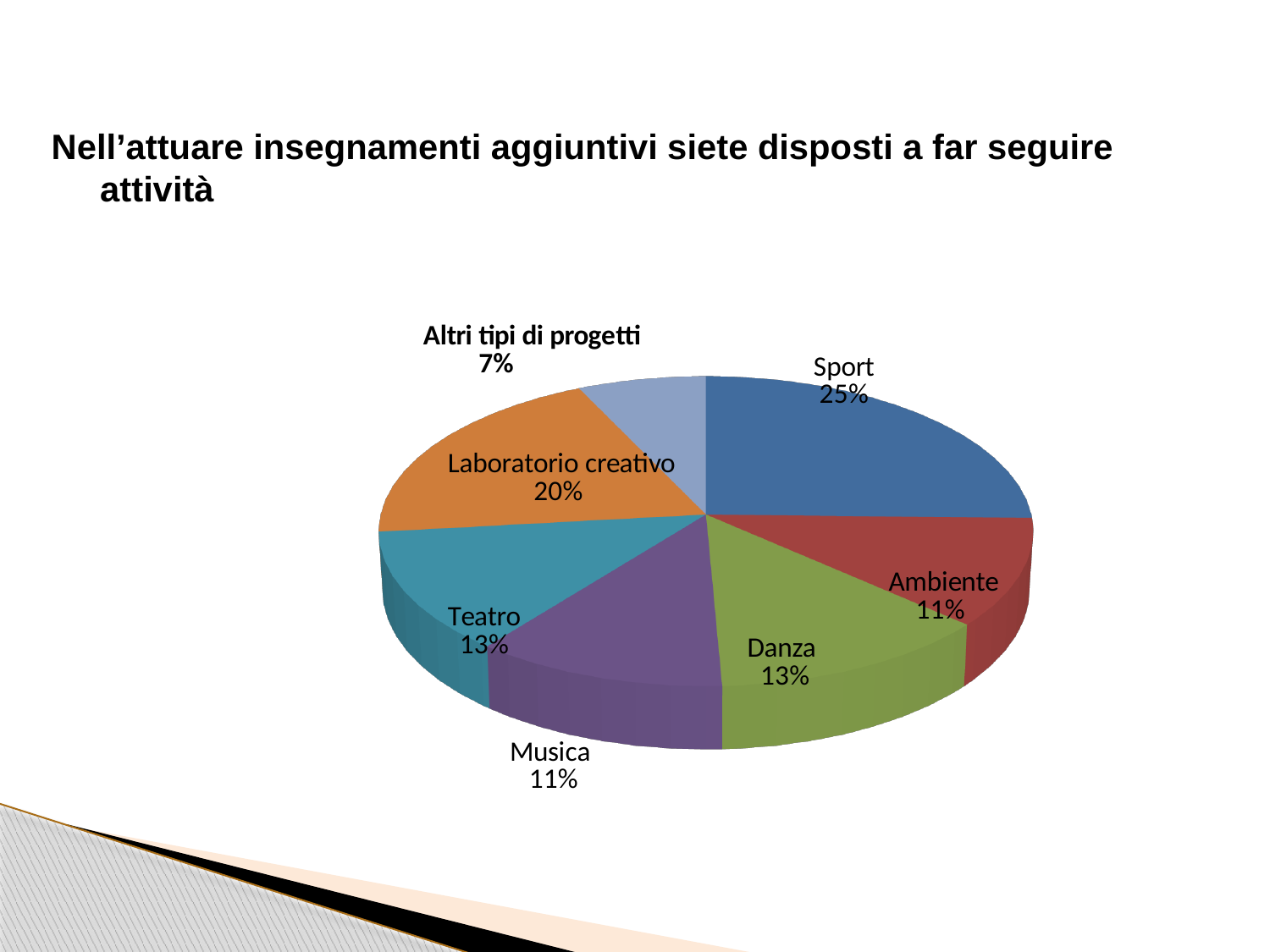
What colour is the Sport slice? Blue What kind of chart is shown on the slide? Pie chart Which category has the largest slice of the pie? Sport Which category has the smallest slice of the pie? Altri tipi di progetti What share of the pie does Sport have? 25% What share of the pie does Laboratorio creativo have? 20% What is the value shown for Altri tipi di progetti? 7% What is the difference in percentage points between Laboratorio creativo and Altri tipi di progetti? 13 Which is larger, the slice for Danza or the slice for Musica? Danza What is the value shown for Teatro? 13% What is the difference in percentage points between Sport and Laboratorio creativo? 5 How many categories are shown in the pie chart? 7